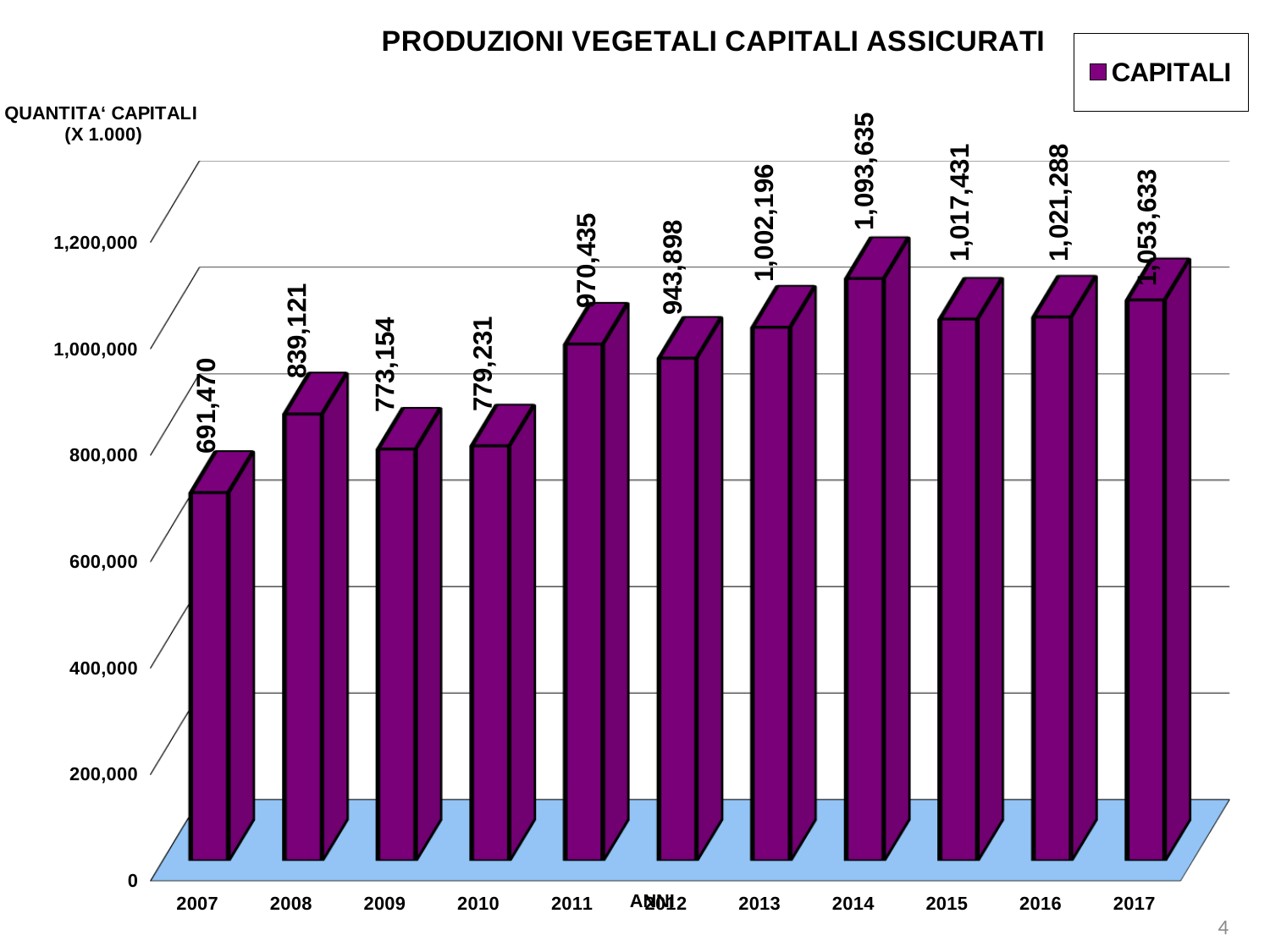
What is the difference between the values for 2014 and 2007? 402,165 Which year has the lowest value? 2007 How many years are shown on the x axis? 11 What is the difference between the values for 2008 and 2007? 147,651 Which is larger, the value for 2011 or the value for 2012? 2011 What kind of chart is shown on the slide? bar chart What is the value for 2007? 691,470 Which year has the highest value? 2014 Is the value for 2007 greater or less than 800,000? less What is the value for 2014? 1,093,635 How many series does the legend list? 1 What is the value for 2017? 1,053,633